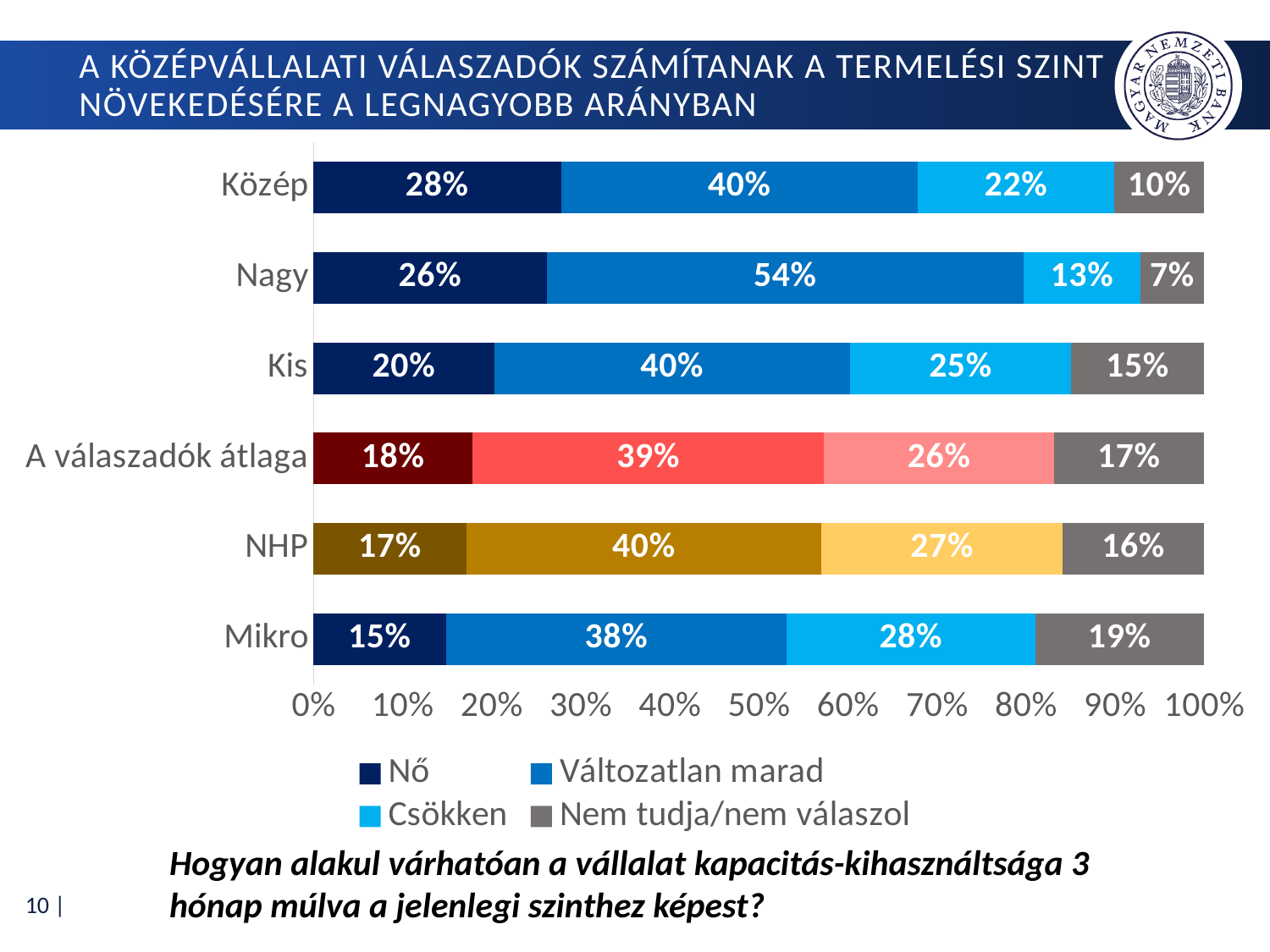
Which category has the highest 'Nő' value? Közép How many series does the legend list? 4 Which is larger, the 'Csökken' value for Kis or for NHP? NHP Which category has the lowest 'Nem tudja/nem válaszol' value? Nagy What kind of chart is shown on the slide? Stacked bar chart What is the 'Változatlan marad' value for Nagy? 54% Which legend entry is shown in grey? Nem tudja/nem válaszol What is the 'Nő' value for Közép? 28% What is the 'Nem tudja/nem válaszol' value for A válaszadók átlaga? 17% What is the 'Csökken' value for Mikro? 28% How many categories are shown on the chart? 6 What is the difference between the 'Változatlan marad' values for Nagy and Mikro? 16%